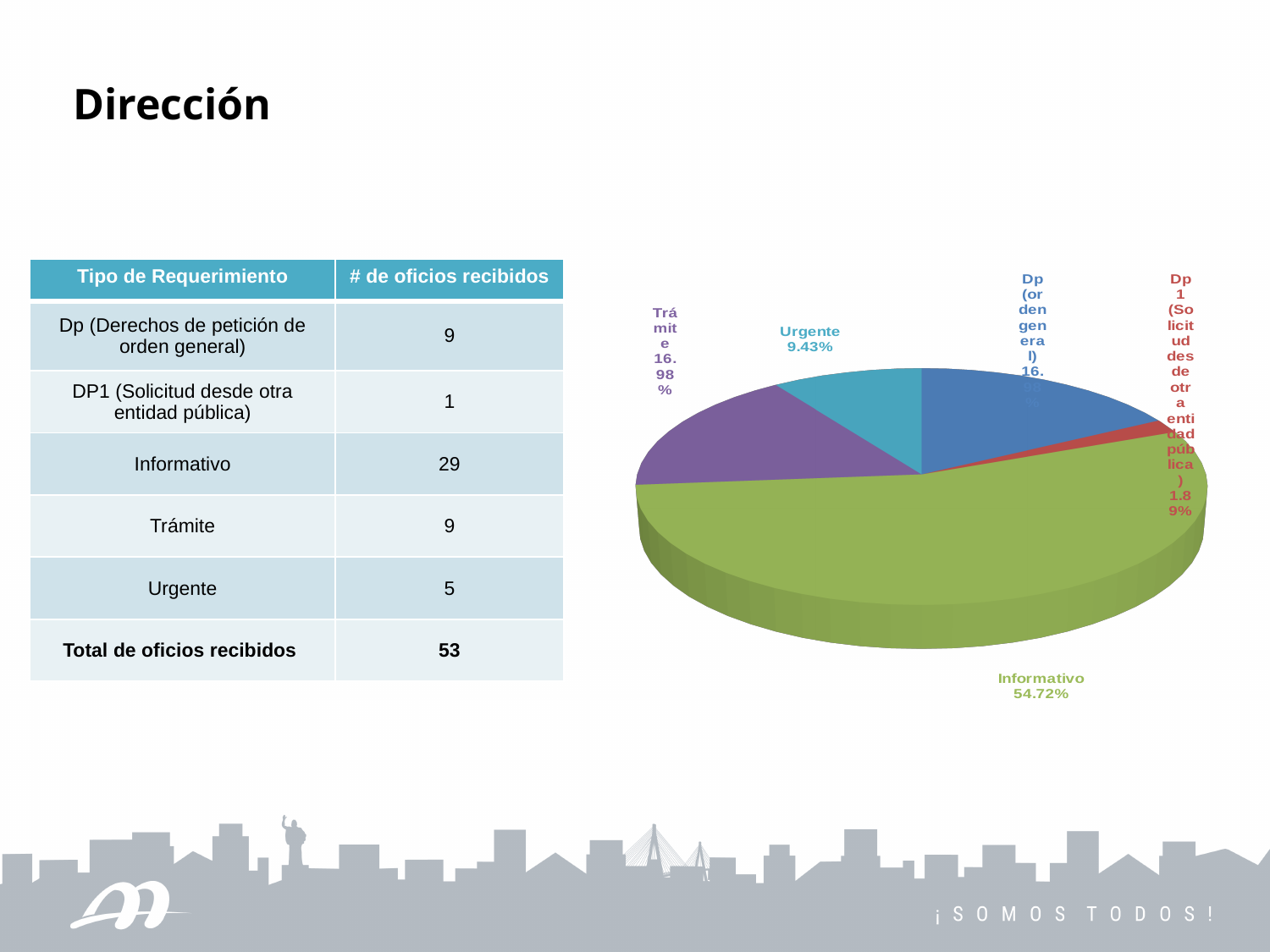
Which category has the largest slice in the pie chart? Informativo What share of the pie chart does Urgente represent? 9.43% What share of the pie chart does Trámite represent? 16.98% What type of chart is shown on the slide? pie chart What is the difference in percentage points between the Informativo and Urgente slices? 45.29 What colour is the Informativo slice in the pie chart? green Which slice is larger in the pie chart, Urgente or Trámite? Trámite What share of the pie chart does DP1 (Solicitud desde otra entidad pública) represent? 1.89% Which category has the smallest slice in the pie chart? DP1 (Solicitud desde otra entidad pública) How many slices does the pie chart have? 5 Is the Informativo slice greater or less than 50% of the pie? greater